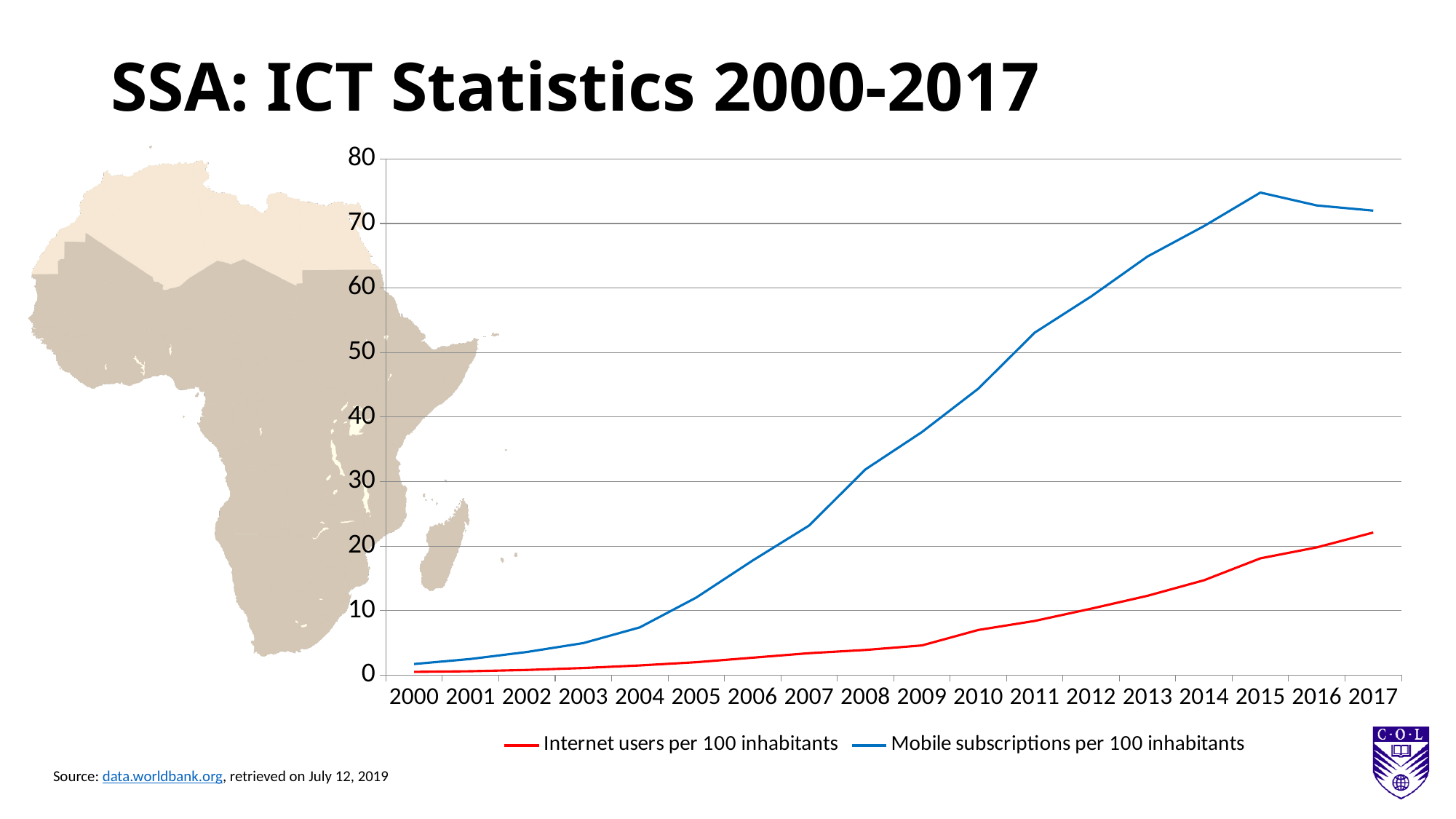
Which series is higher in 2017, Internet users per 100 inhabitants or Mobile subscriptions per 100 inhabitants? Mobile subscriptions per 100 inhabitants Is the value for Internet users per 100 inhabitants in 2017 greater or less than 20? greater How many series does the legend list? 2 How many years are plotted along the x axis? 18 Is the value for Internet users per 100 inhabitants in 2010 greater or less than 10? less Is the value for Mobile subscriptions per 100 inhabitants in 2015 greater or less than 70? greater What is the title of the slide's chart? SSA: ICT Statistics 2000-2017 Do the values for Internet users per 100 inhabitants rise or fall from 2000 to 2017? rise What kind of chart is shown on the slide? line chart Which colour is used for the Internet users per 100 inhabitants line? red In which year does the Mobile subscriptions per 100 inhabitants series reach its highest value? 2015